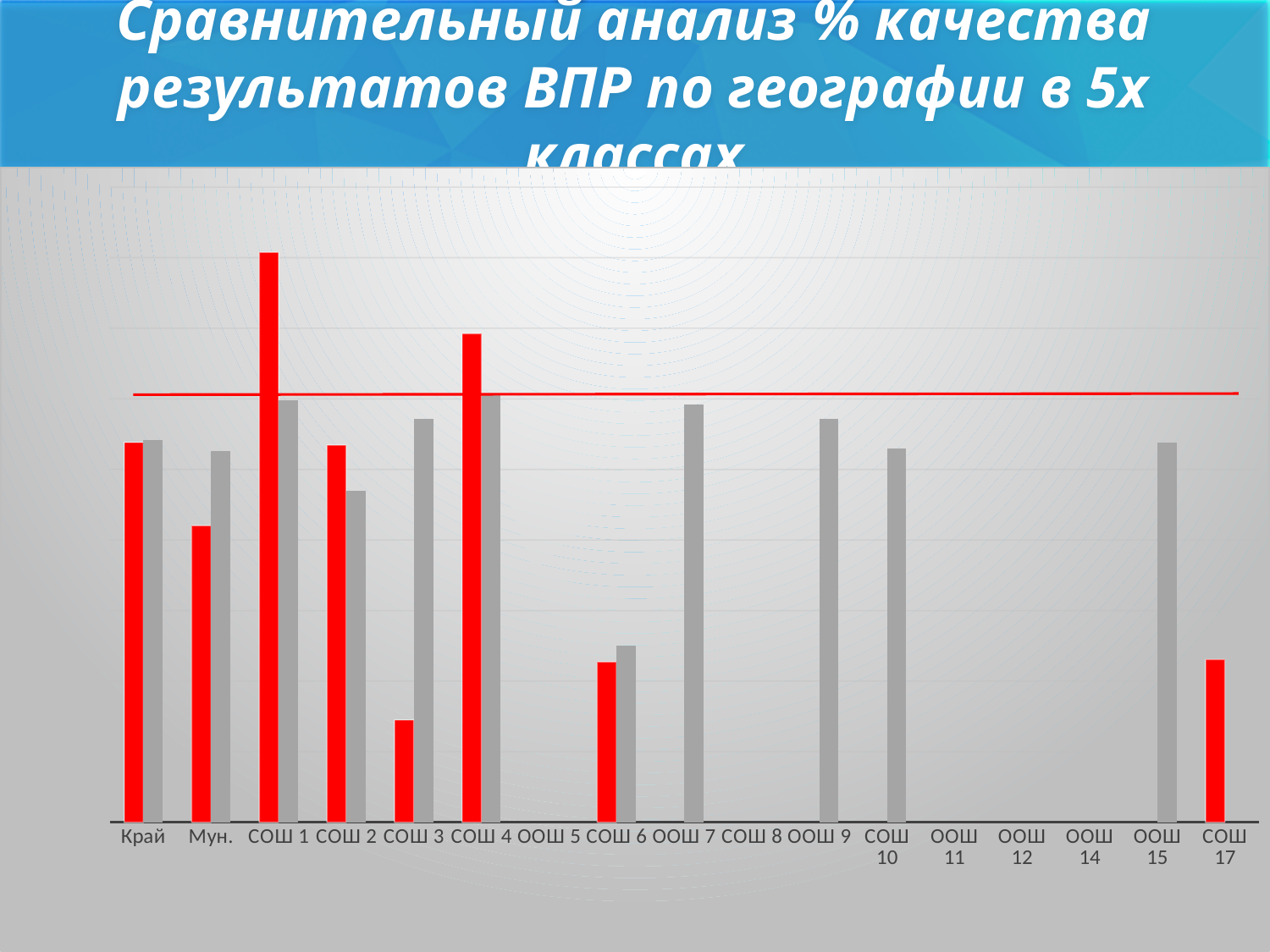
Which category has the shortest gray bar? СОШ 6 Which red bar is taller, СОШ 1 or СОШ 4? СОШ 1 What subject is named in the slide title? география How many categories are shown along the x axis of the chart? 17 Which red bar is taller, СОШ 3 or СОШ 6? СОШ 6 What two colours are used for the bars in the chart? red and gray Which category has the tallest red bar? СОШ 1 Which red bar is taller, Край or Мун.? Край Which category has the shortest red bar? СОШ 3 What kind of chart is shown on the slide? bar chart How many categories have no bars at all? 5